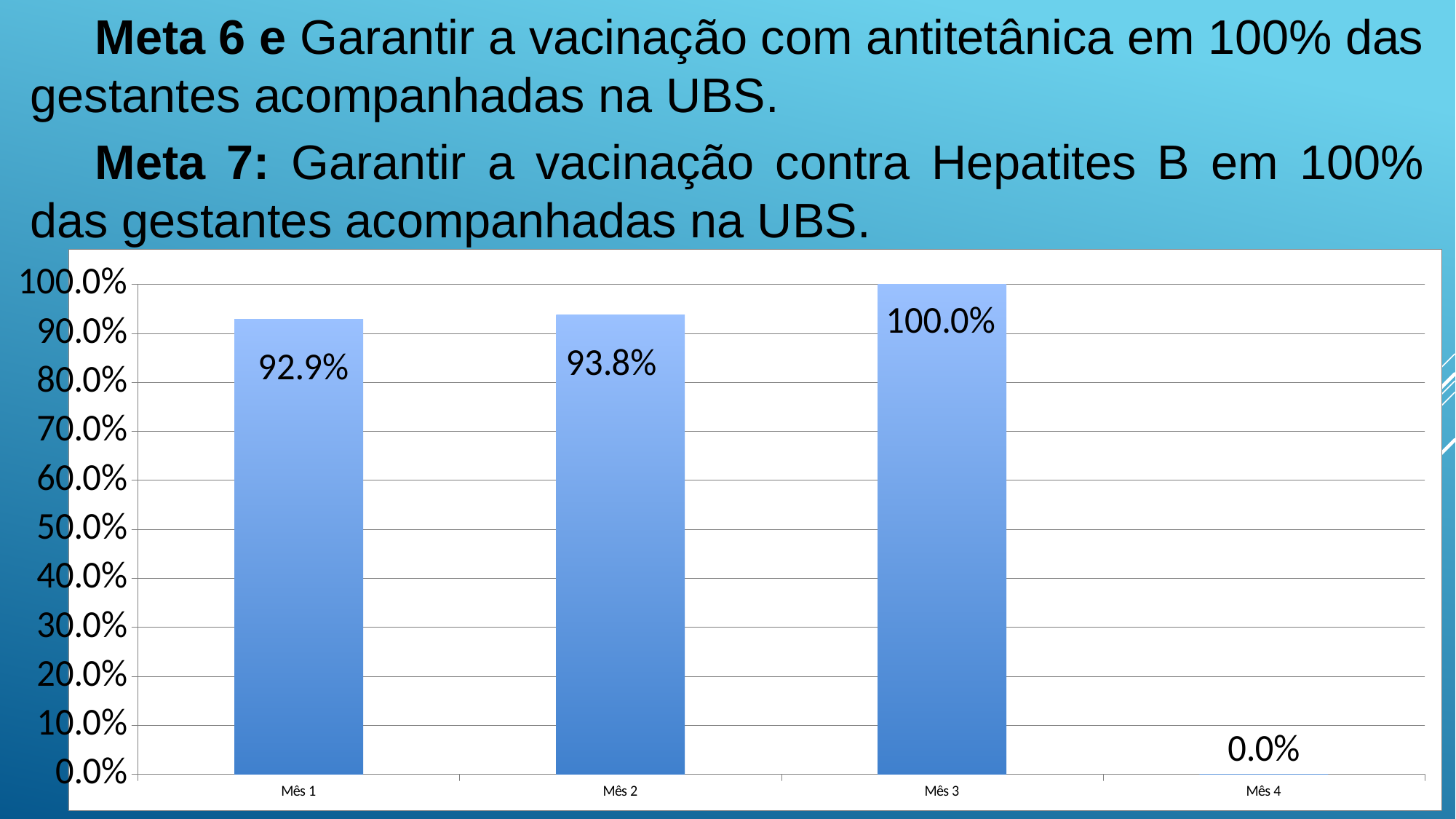
What is the difference between the values for Mês 2 and Mês 1? 0.9% What is the value for Mês 3? 100.0% Which month has the lowest value? Mês 4 What is the value for Mês 2? 93.8% What kind of chart is shown on the slide? bar chart Which is larger, the value for Mês 3 or the value for Mês 2? Mês 3 How many categories are shown on the x axis? 4 Which month has the highest value? Mês 3 What is the value for Mês 4? 0.0% What is the difference between the values for Mês 3 and Mês 1? 7.1% Is the value for Mês 1 greater or less than 90.0%? greater What is the value for Mês 1? 92.9%